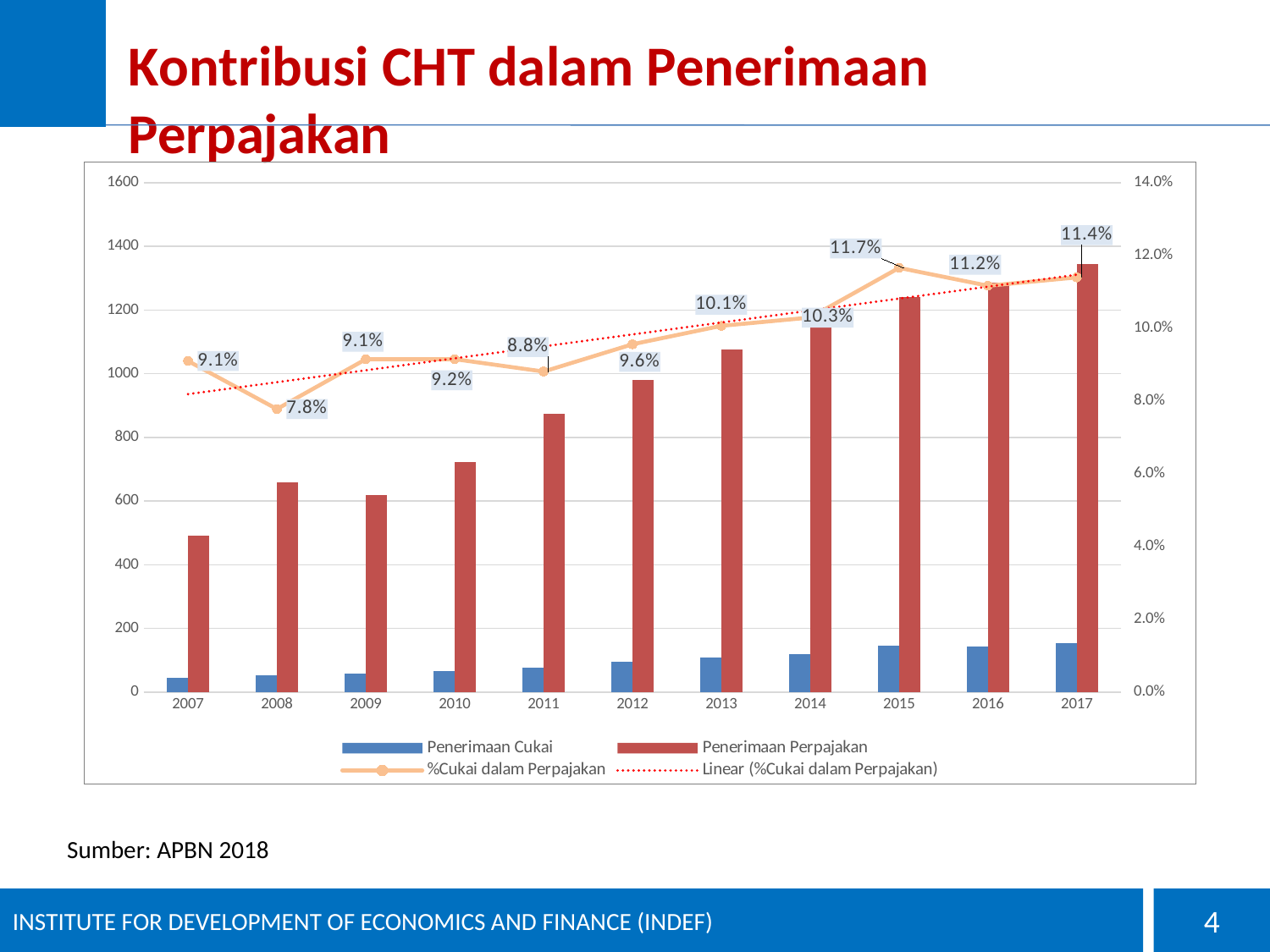
Which is larger, %Cukai dalam Perpajakan in 2013 or in 2012? 2013 Is the value of Penerimaan Perpajakan for 2017 greater or less than 1200? greater What is the value of %Cukai dalam Perpajakan for 2008? 7.8% Is the value of Penerimaan Perpajakan for 2007 greater or less than 600? less In which year is %Cukai dalam Perpajakan highest? 2015 What is the difference between %Cukai dalam Perpajakan in 2015 and in 2008? 3.9 percentage points Does Penerimaan Cukai rise or fall from 2007 to 2017? rise What is the value of %Cukai dalam Perpajakan for 2015? 11.7% In which year is %Cukai dalam Perpajakan lowest? 2008 What is the value of %Cukai dalam Perpajakan for 2017? 11.4% How many entries does the chart legend list? 4 How many years are shown on the x axis of the chart? 11